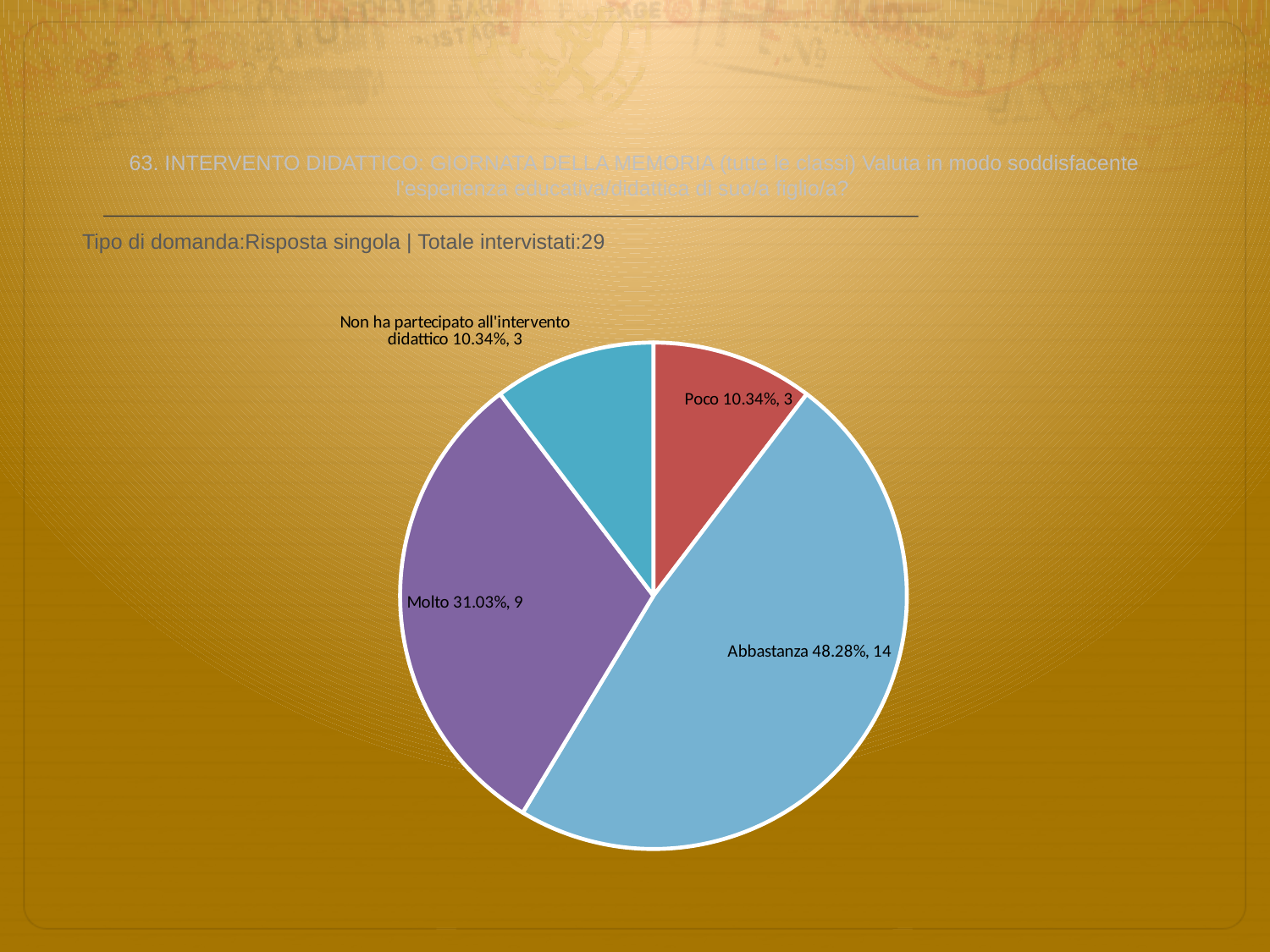
What is the total number of respondents shown in the chart? 29 What is the percentage share of the Molto slice? 31.03% What is the difference in respondent count between Abbastanza and Molto? 5 Which category has the largest slice of the pie? Abbastanza Which is larger, the Molto slice or the Poco slice? Molto What percentage share does the Abbastanza slice have? 48.28% What colour is the Molto slice? purple How many slices does the pie chart have? 4 How many respondents answered Non ha partecipato all'intervento didattico? 3 How many respondents answered Molto? 9 What kind of chart is shown on the slide? pie chart What percentage share does the Poco slice have? 10.34%